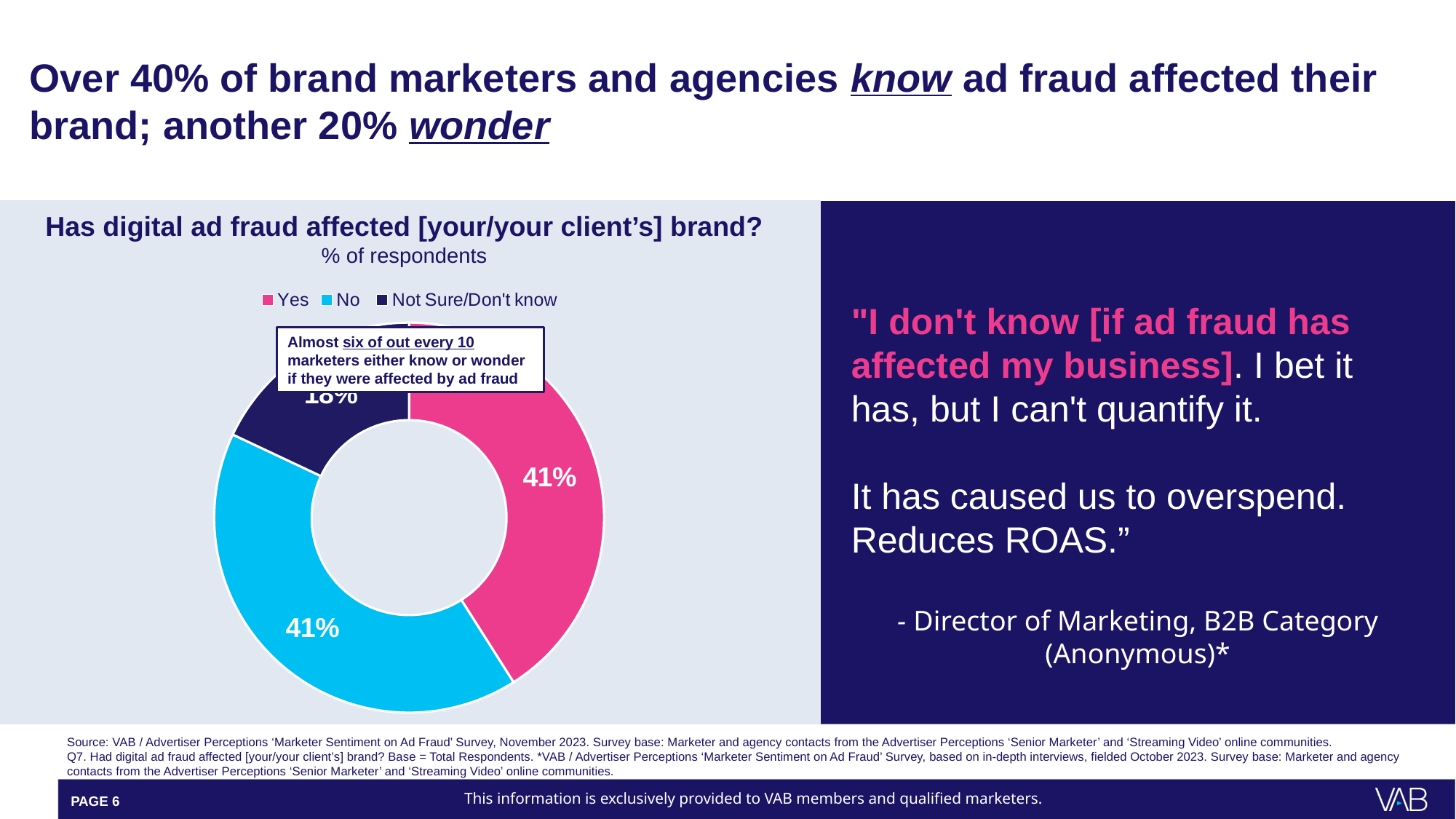
How many response categories are shown in the donut chart? 3 What percentage of respondents answered No? 41% What is the difference between the Yes and No percentages? 0 percentage points What percentage of respondents answered Yes to whether digital ad fraud affected their brand? 41% Which colour represents the No category in the chart? Light blue How many entries does the chart legend list? 3 What share of the donut chart does the Yes slice represent? 41% What is the title of the chart? Has digital ad fraud affected [your/your client's] brand? Which response category has the smallest slice of the donut chart? Not Sure/Don't know Is the Yes slice larger than, smaller than, or equal to the No slice? Equal What type of chart is used to show the survey responses? Donut (pie) chart